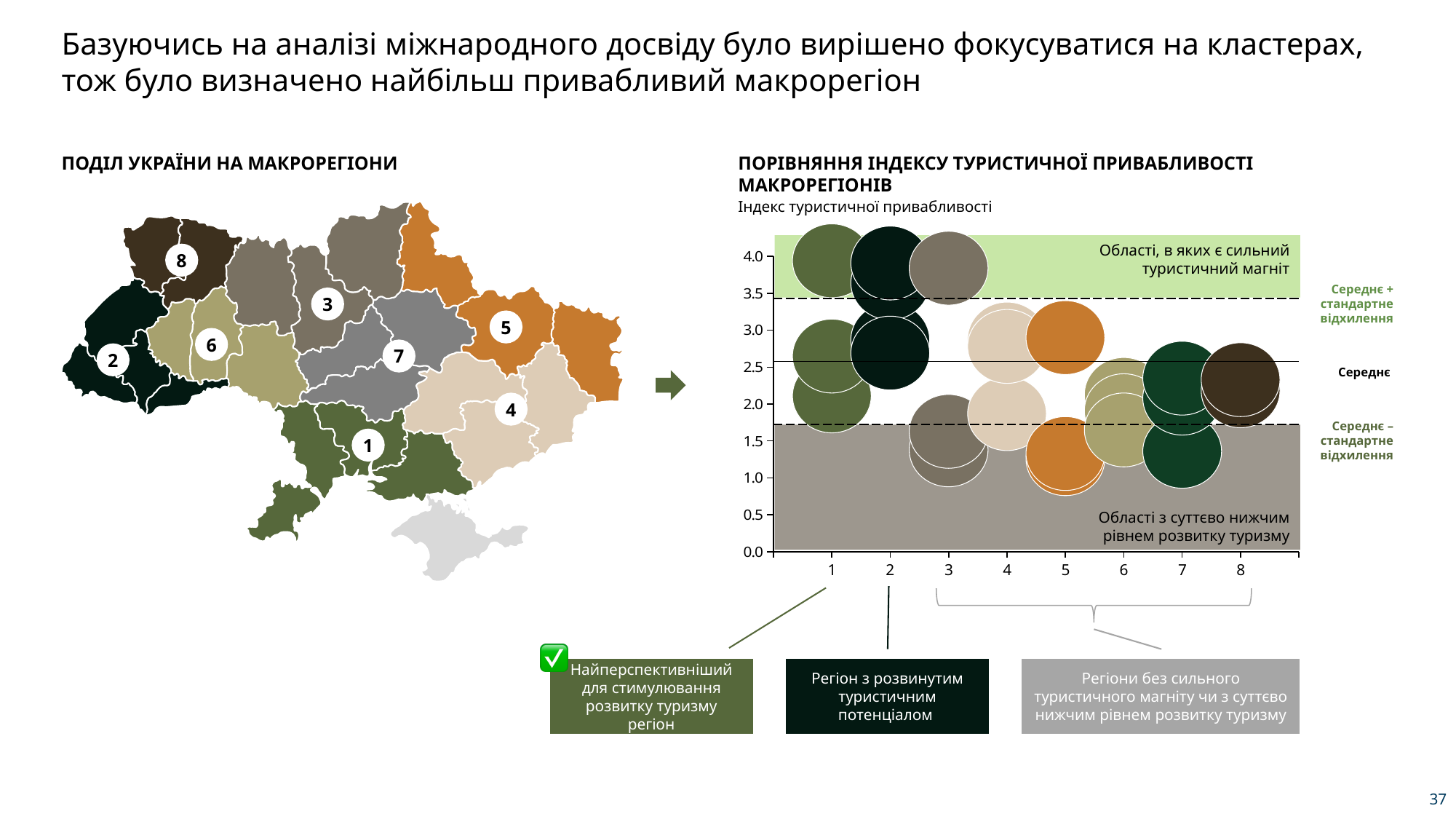
In the chart on the right, is the topmost bubble for macroregion 1 greater or less than 3.0? greater In the chart on the right, is the value for macroregion 8 greater or less than 1.0? greater What is the title of the chart on the right side of the slide? ПОРІВНЯННЯ ІНДЕКСУ ТУРИСТИЧНОЇ ПРИВАБЛИВОСТІ МАКРОРЕГІОНІВ In the chart on the right, how many macroregions are shown along the x axis? 8 In the chart on the right, is the topmost bubble for macroregion 2 greater or less than 3.0? greater According to the annotation below the chart on the right, which macroregion is labelled 'Найперспективніший для стимулювання розвитку туризму регіон'? 1 What kind of chart is the chart titled 'ПОРІВНЯННЯ ІНДЕКСУ ТУРИСТИЧНОЇ ПРИВАБЛИВОСТІ МАКРОРЕГІОНІВ'? bubble chart